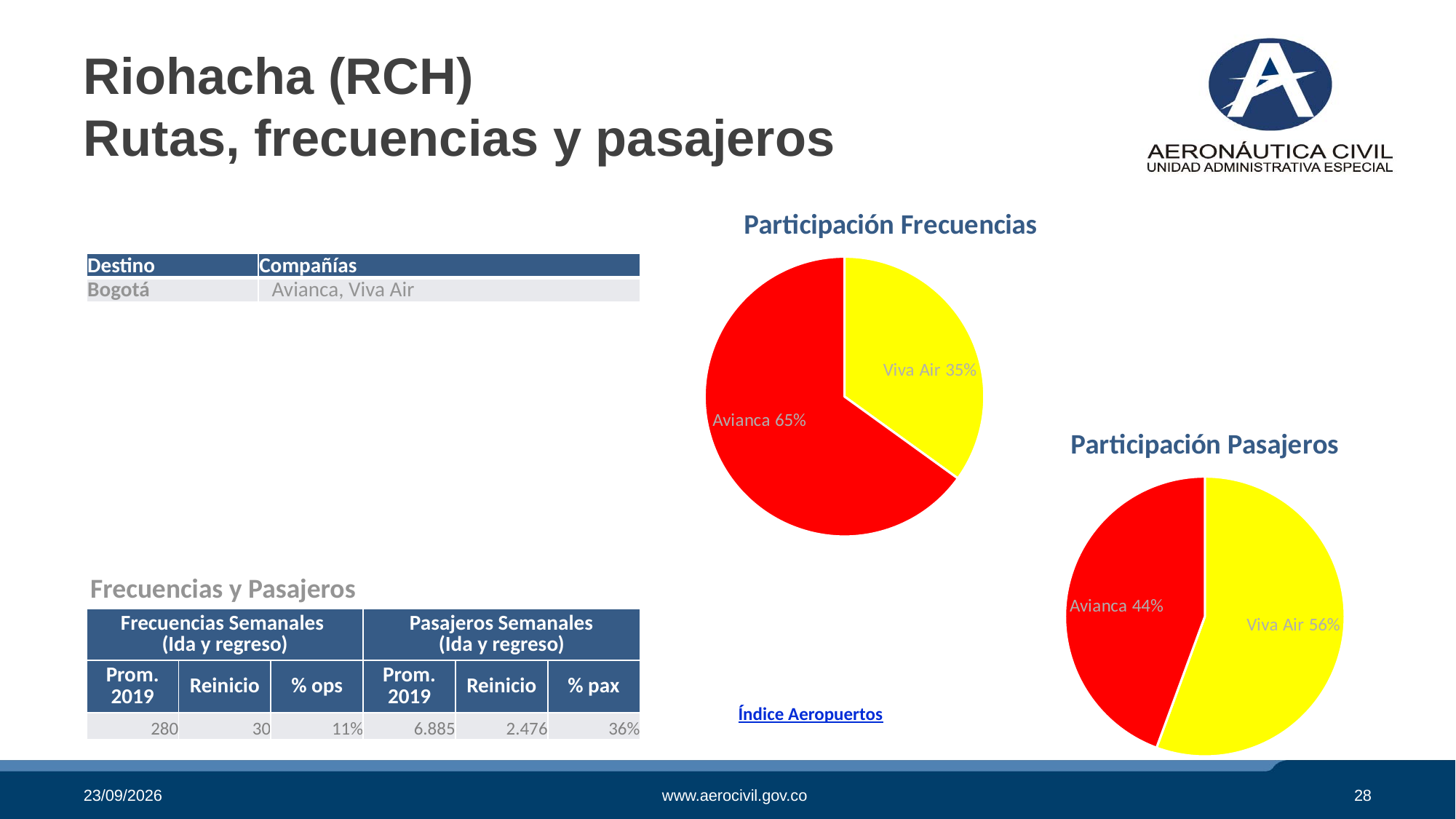
In the 'Participación Frecuencias' chart, what share does Avianca have? 65% How many slices does the 'Participación Frecuencias' chart have? 2 In the 'Participación Pasajeros' chart, what share does Viva Air have? 56% In the 'Participación Frecuencias' chart, what is the difference in percentage points between Avianca and Viva Air? 30 What kind of chart is 'Participación Pasajeros'? Pie chart In the 'Participación Frecuencias' chart, what colour is the Avianca slice? Red In the 'Participación Pasajeros' chart, which is larger, Avianca or Viva Air? Viva Air In the 'Participación Pasajeros' chart, which airline has the smallest slice? Avianca In the 'Participación Pasajeros' chart, what share does Avianca have? 44% In the 'Participación Frecuencias' chart, what share does Viva Air have? 35% In the 'Participación Pasajeros' chart, what is the difference in percentage points between Viva Air and Avianca? 12 In the 'Participación Frecuencias' chart, which airline has the largest slice? Avianca